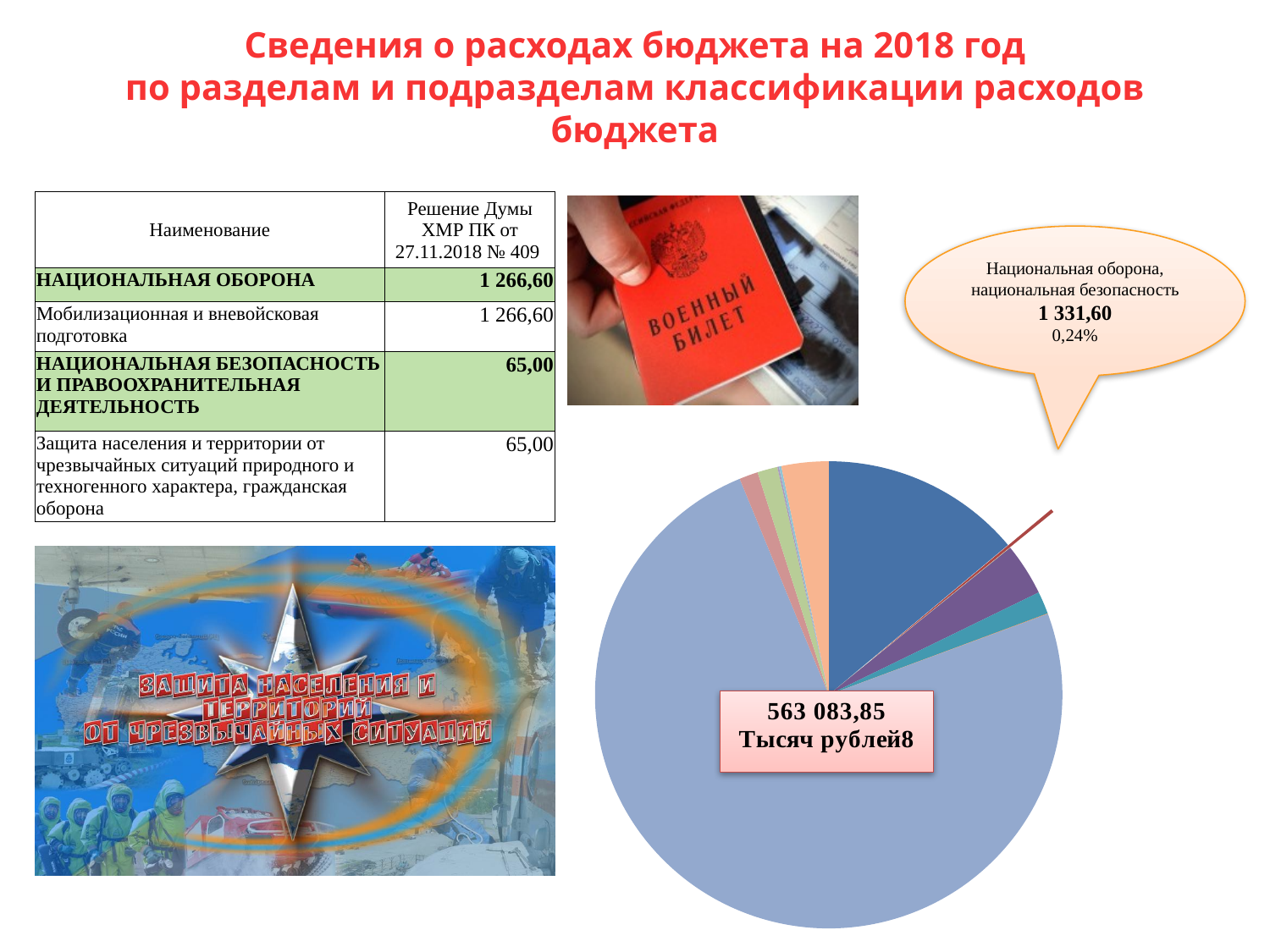
Is the share of the pie for Национальная оборона, национальная безопасность greater or less than 1%? less According to the callout on the pie chart, what share of the pie does Национальная оборона, национальная безопасность represent? 0,24% What total value is printed in the label in the centre of the pie chart? 563 083,85 Does the pie chart display a legend listing its categories? No What kind of chart is shown on the slide? pie chart According to the callout on the pie chart, what is the value for Национальная оборона, национальная безопасность? 1 331,60